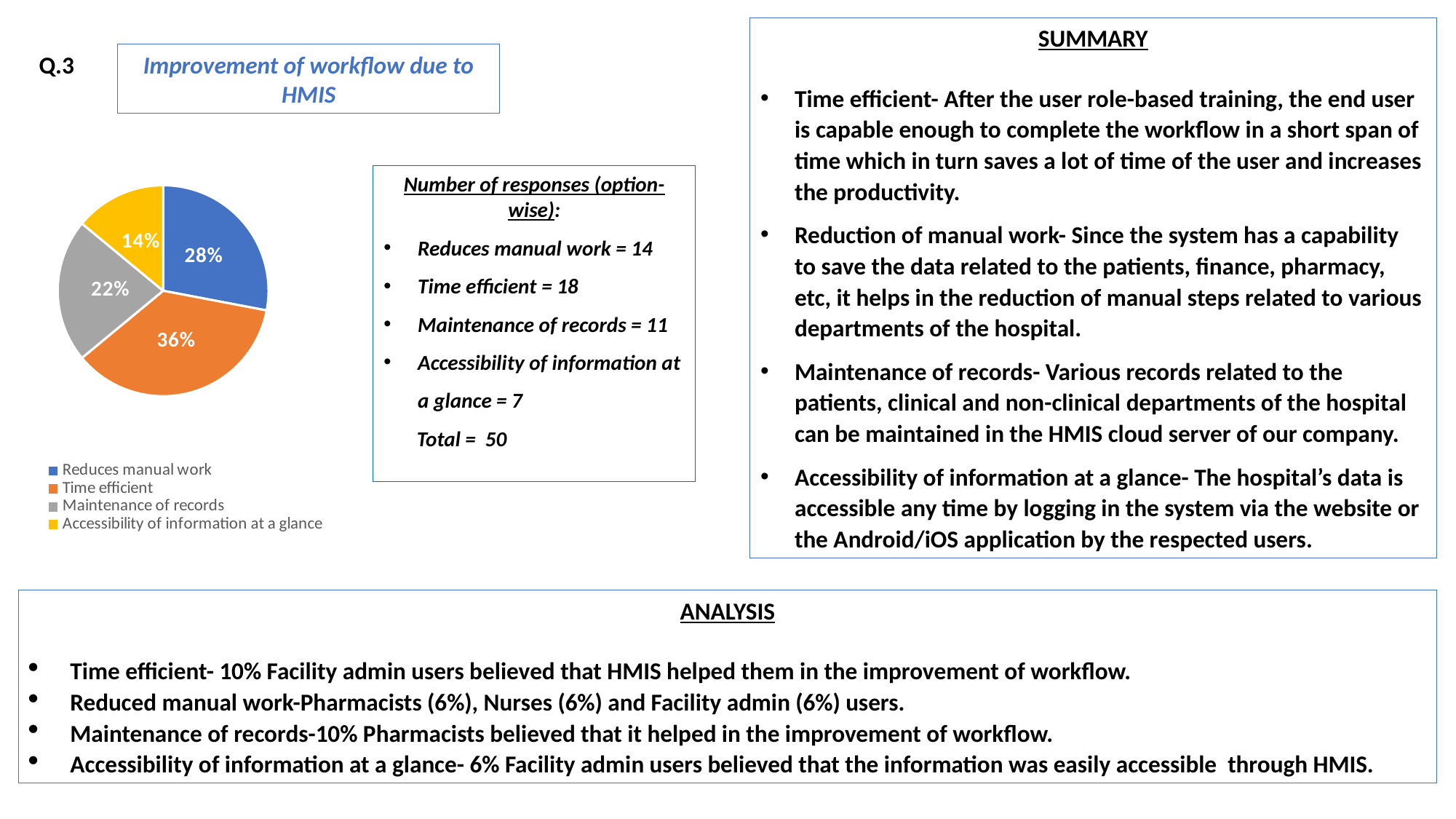
How many slices does the pie chart have? 4 What percentage of the pie does Accessibility of information at a glance account for? 14% Which category has the largest slice of the pie? Time efficient Which legend entry is shown in grey? Maintenance of records What percentage of the pie does Reduces manual work account for? 28% What percentage of the pie does Time efficient account for? 36% Which slice is larger: Maintenance of records or Accessibility of information at a glance? Maintenance of records What percentage of the pie does Maintenance of records account for? 22% What colour is the Time efficient slice? orange What is the difference in percentage points between the Time efficient slice and the Reduces manual work slice? 8 Which category has the smallest slice of the pie? Accessibility of information at a glance What kind of chart is shown on the slide? pie chart